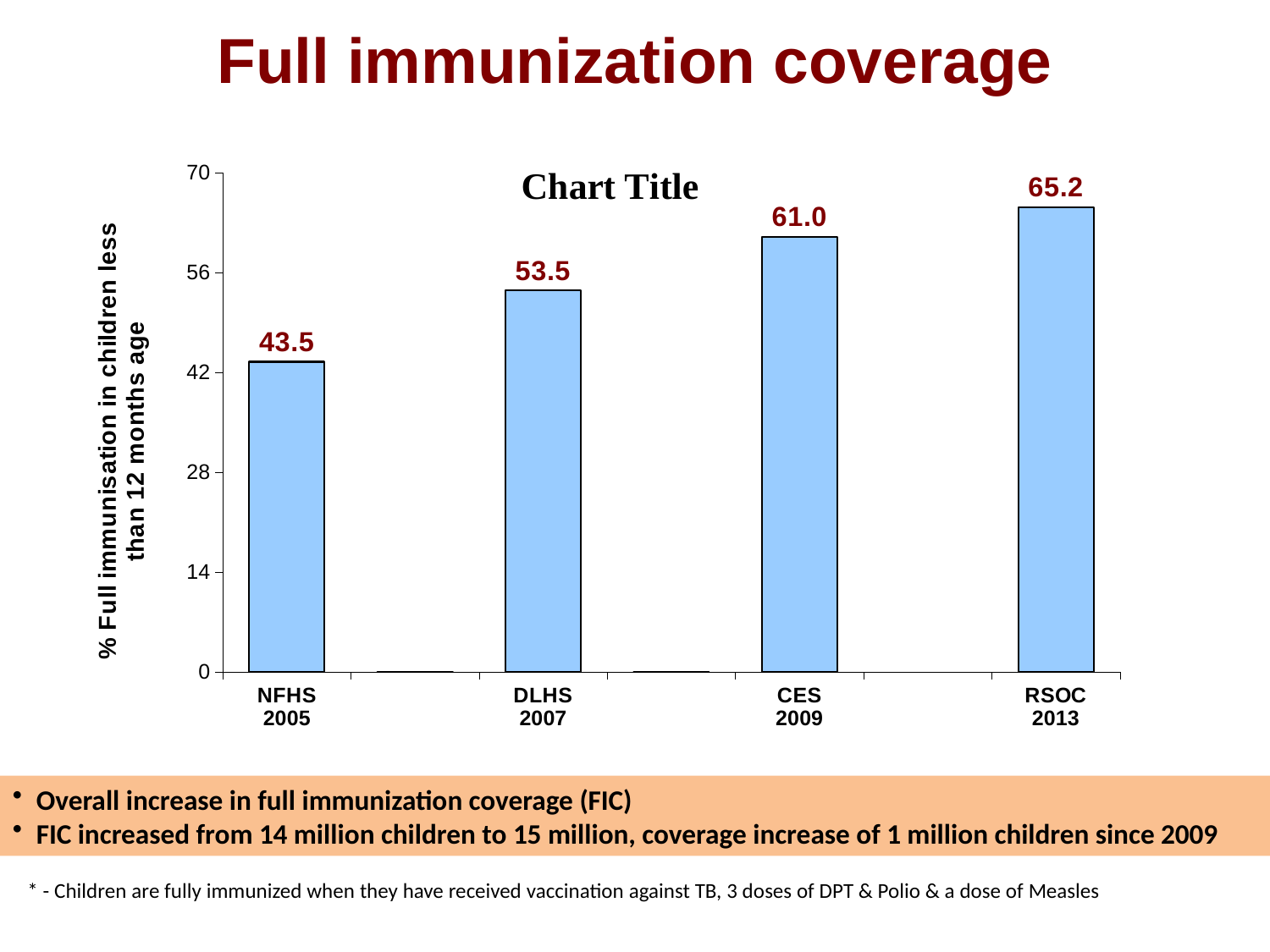
What is the full immunization coverage value for CES 2009? 61.0 Which survey shows the lowest full immunization coverage? NFHS 2005 What is the full immunization coverage value for NFHS 2005? 43.5 What kind of chart is shown on the slide? Bar chart What is the difference between the CES 2009 and DLHS 2007 values? 7.5 What is the full immunization coverage value for DLHS 2007? 53.5 How many surveys (bars) are shown in the chart? 4 What is the full immunization coverage value for RSOC 2013? 65.2 What is the difference between the RSOC 2013 and NFHS 2005 values? 21.7 Do the values rise or fall from NFHS 2005 to RSOC 2013? Rise Which is larger, the value for DLHS 2007 or the value for CES 2009? CES 2009 Which survey shows the highest full immunization coverage? RSOC 2013